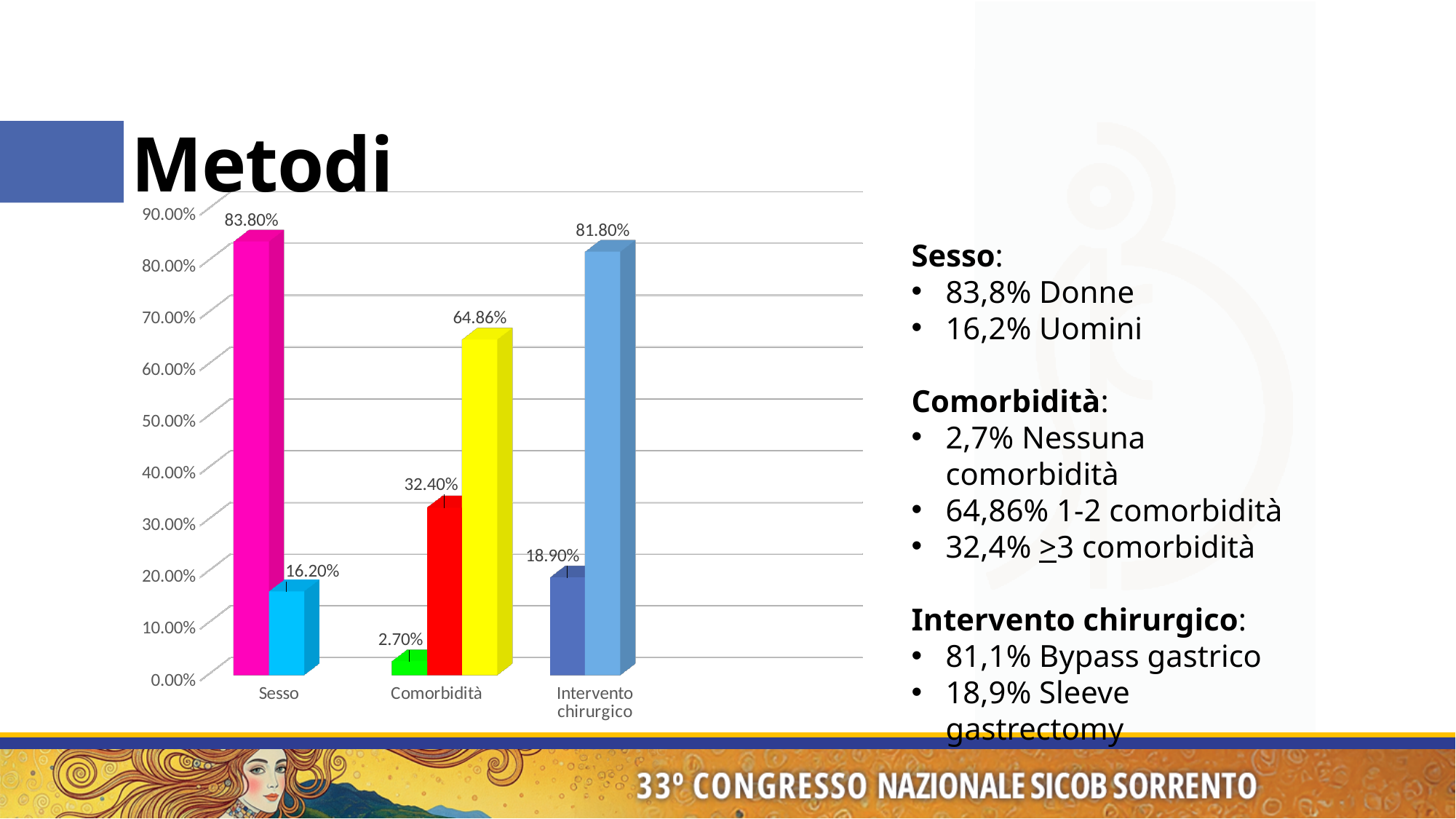
What is the value of the red bar in the Comorbidità category? 32.40% What is the difference between the two bars in the Sesso category? 67.60% What is the value of the shorter (light blue) bar in the Sesso category? 16.20% What is the highest value shown on the chart's vertical axis? 90.00% What is the value of the yellow bar in the Comorbidità category? 64.86% What is the value of the tallest bar in the Sesso category? 83.80% Which is larger: the yellow bar in Comorbidità or the light blue bar in Intervento chirurgico? the light blue bar in Intervento chirurgico What type of chart is shown on the slide? bar chart What is the value of the tallest bar in the Intervento chirurgico category? 81.80% Which bar in the Comorbidità category has the lowest value? the green bar (2.70%) How many categories are shown on the x axis of the chart? 3 What is the value of the green bar in the Comorbidità category? 2.70%